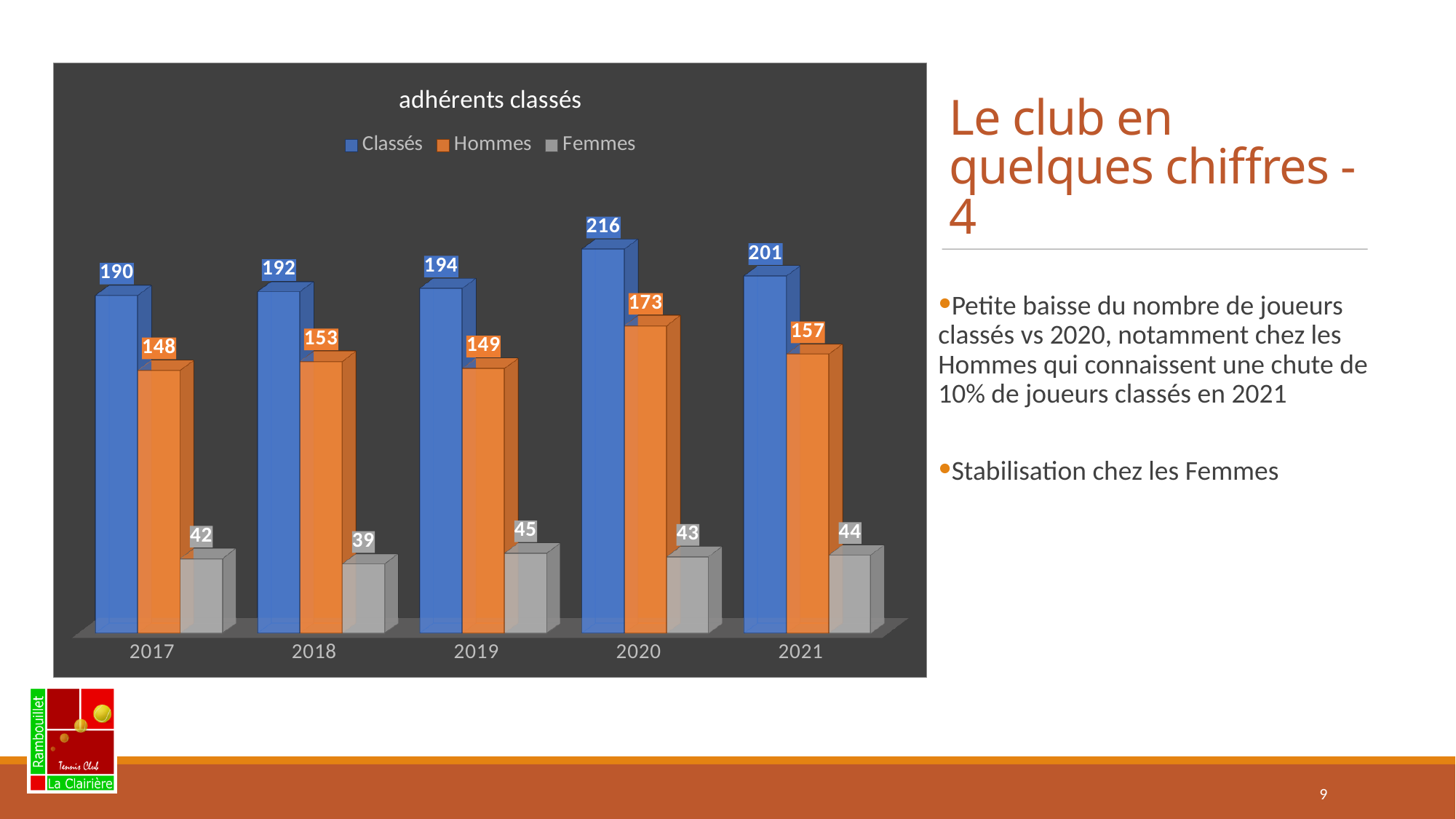
Do the Classés values rise or fall from 2017 to 2020? Rise How many years are shown on the x axis? 5 What is the value for Hommes in 2018? 153 How many series does the legend list? 3 What is the difference between the Hommes values for 2020 and 2021? 16 Which is larger, the Classés value for 2017 or for 2021? 2021 What is the value for Femmes in 2019? 45 What kind of chart is shown on the slide? Bar chart Which year has the lowest value for Femmes? 2018 Which year has the highest value for Classés? 2020 What is the value for Classés in 2020? 216 What is the title of the chart? adhérents classés